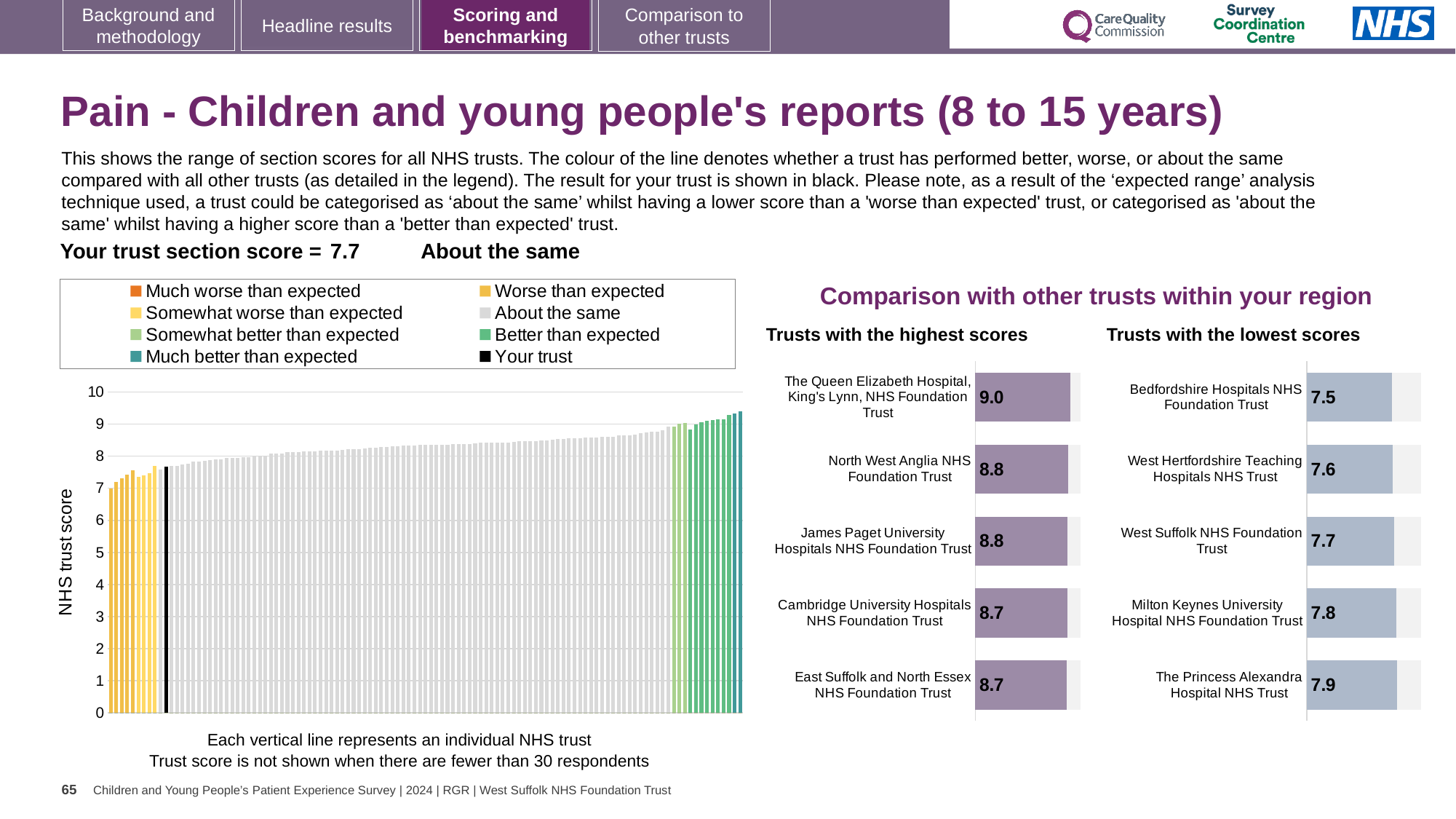
In the 'NHS trust score' chart on the left, do the bar values rise or fall from left to right? Rise In the 'Trusts with the lowest scores' chart, which trust has the lowest score? Bedfordshire Hospitals NHS Foundation Trust What kind of chart is the 'NHS trust score' chart on the left of the slide? Bar chart In the 'Trusts with the lowest scores' chart, what is the score for Bedfordshire Hospitals NHS Foundation Trust? 7.5 In the 'Trusts with the highest scores' chart, what is the difference between the scores of The Queen Elizabeth Hospital, King's Lynn and Cambridge University Hospitals NHS Foundation Trust? 0.3 How many trusts are listed in the 'Trusts with the highest scores' chart? 5 In the 'Trusts with the lowest scores' chart, which has the larger score: West Hertfordshire Teaching Hospitals NHS Trust or The Princess Alexandra Hospital NHS Trust? The Princess Alexandra Hospital NHS Trust In the 'Trusts with the highest scores' chart, what is the score for The Queen Elizabeth Hospital, King's Lynn, NHS Foundation Trust? 9.0 In the 'Trusts with the lowest scores' chart, what is the score for Milton Keynes University Hospital NHS Foundation Trust? 7.8 How many entries does the legend of the 'NHS trust score' chart on the left list? 8 In the 'NHS trust score' chart on the left, is the value of the tallest (rightmost) bar greater or less than 9? greater In the 'Trusts with the highest scores' chart, which trust has the highest score? The Queen Elizabeth Hospital, King's Lynn, NHS Foundation Trust